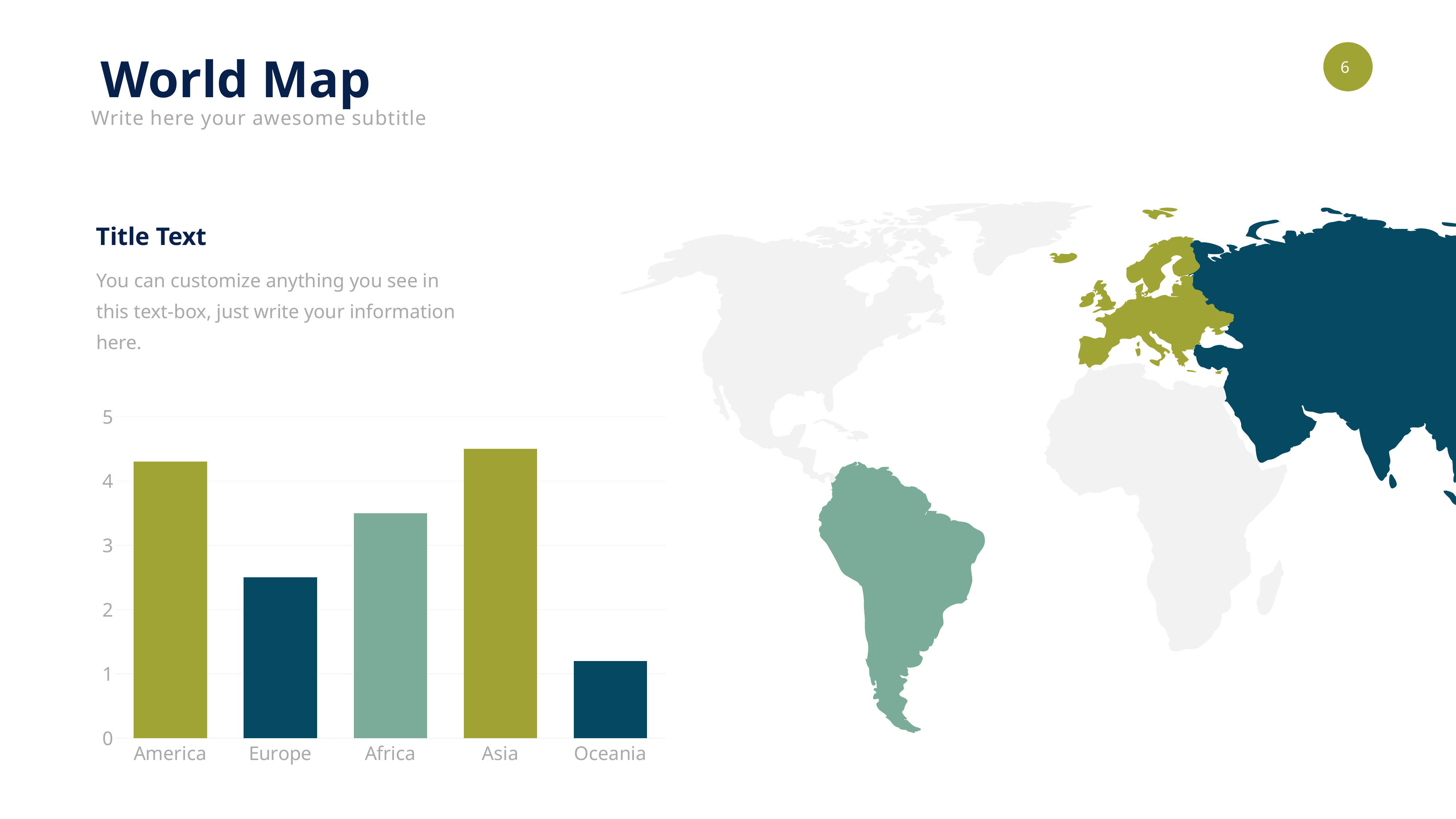
Which is larger, the value for Oceania or the value for Europe? Europe What kind of chart is shown on the slide? bar chart Is the value for Africa greater or less than 3? greater Which is larger, the value for Africa or the value for Europe? Africa Which category has the lowest bar in the chart? Oceania Is the value for Oceania greater or less than 2? less How many categories are shown on the x axis of the bar chart? 5 Is the value for Europe greater or less than 3? less What is the highest value shown on the chart's vertical axis? 5 Which category has the highest bar in the chart? Asia